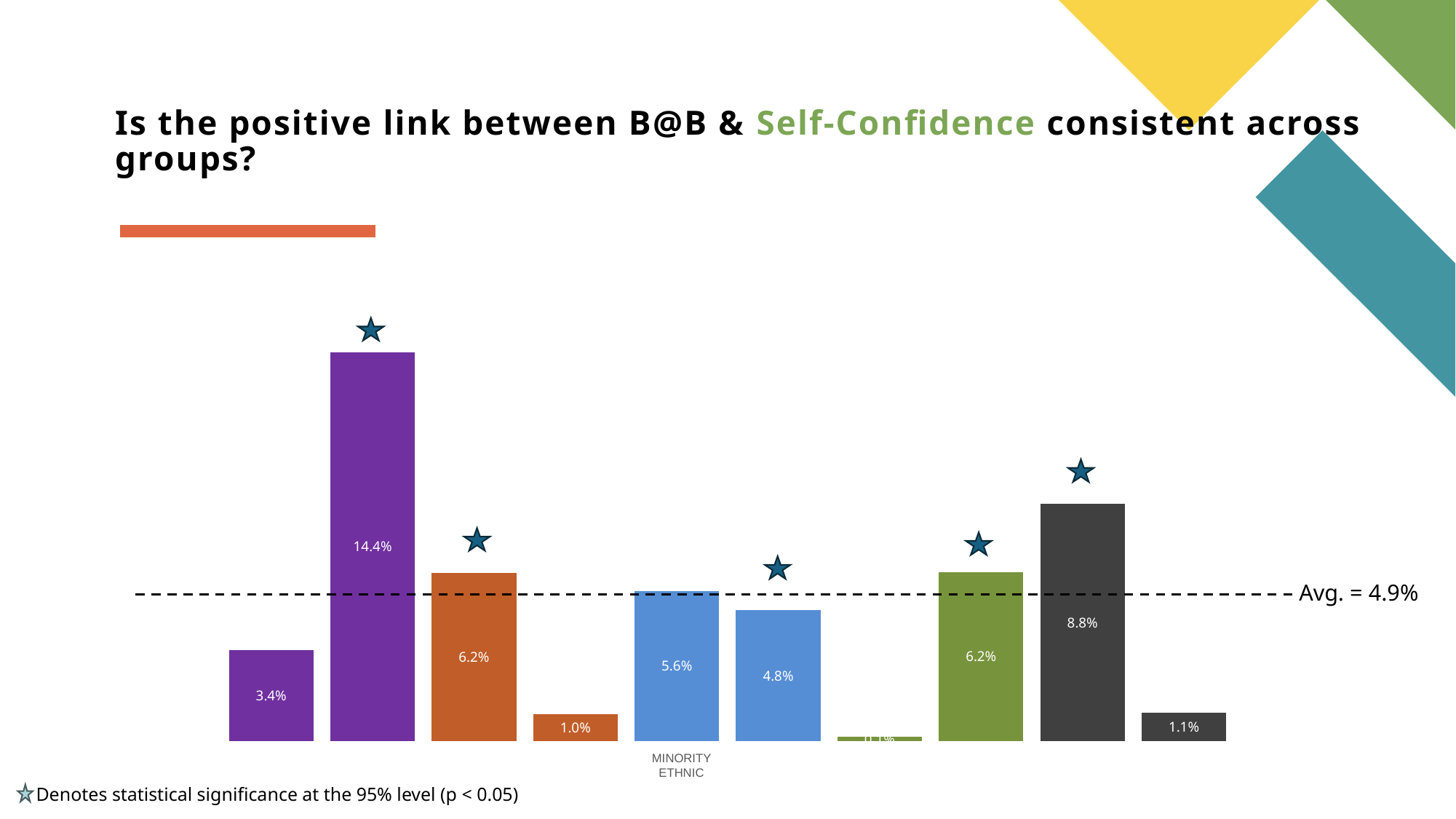
What is the value of the bar labelled Minority Ethnic? 5.6% What is the highest value shown on any bar in the chart? 14.4% How many bars are plotted in the chart? 10 What kind of chart is shown on the slide? bar chart What average value is marked by the dashed line on the chart? Avg. = 4.9% How many bars are marked with a star denoting statistical significance? 5 What is the difference between the highest bar (14.4%) and the Minority Ethnic bar (5.6%)? 8.8% Is the value for Minority Ethnic greater or less than the 4.9% average line? greater What is the value of the last (rightmost) bar in the chart? 1.1% What is the value of the first (leftmost) bar in the chart? 3.4% What is the value of the tallest dark grey bar on the right side of the chart? 8.8% Which is larger: the tallest purple bar or the tallest dark grey bar? the tallest purple bar (14.4%)